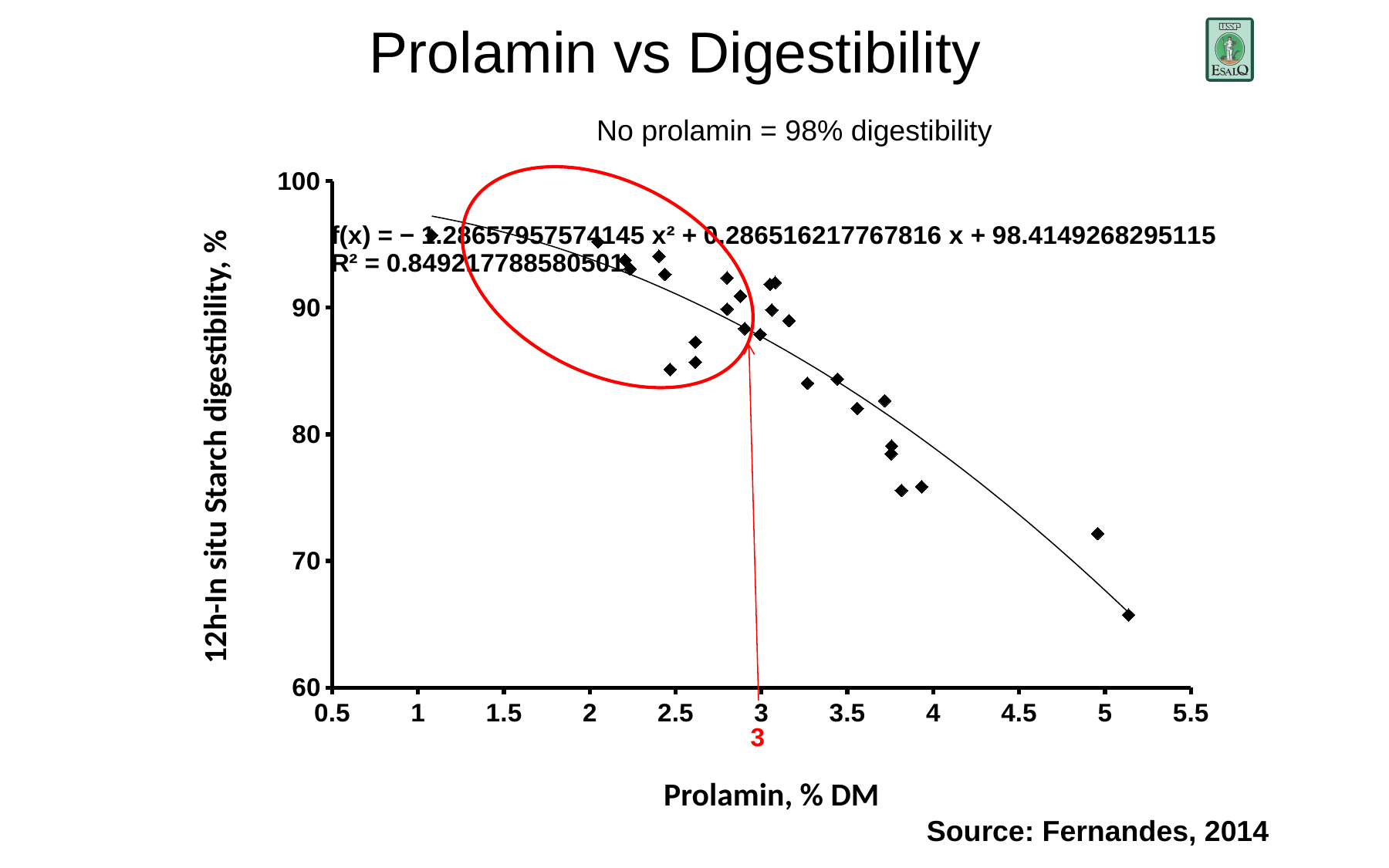
Is the digestibility value for the points near 3.8–3.9% DM prolamin greater or less than 80? less What is the maximum value shown on the y axis? 100 Is the digestibility value for the point at the highest prolamin level (about 5.15% DM) greater or less than 70? less What is the label of the x axis? Prolamin, % DM Is the digestibility value for the point near 4.95% DM prolamin greater or less than 70? greater As prolamin increases along the x axis, does starch digestibility rise or fall? fall What kind of chart is shown on the slide? scatter plot What is the title of the chart? Prolamin vs Digestibility What is the R² value of the fitted curve shown on the chart? 0.849217788580501 Which point has the lowest digestibility: the one near 5.15% DM prolamin or the one near 4.95% DM prolamin? the one near 5.15% DM